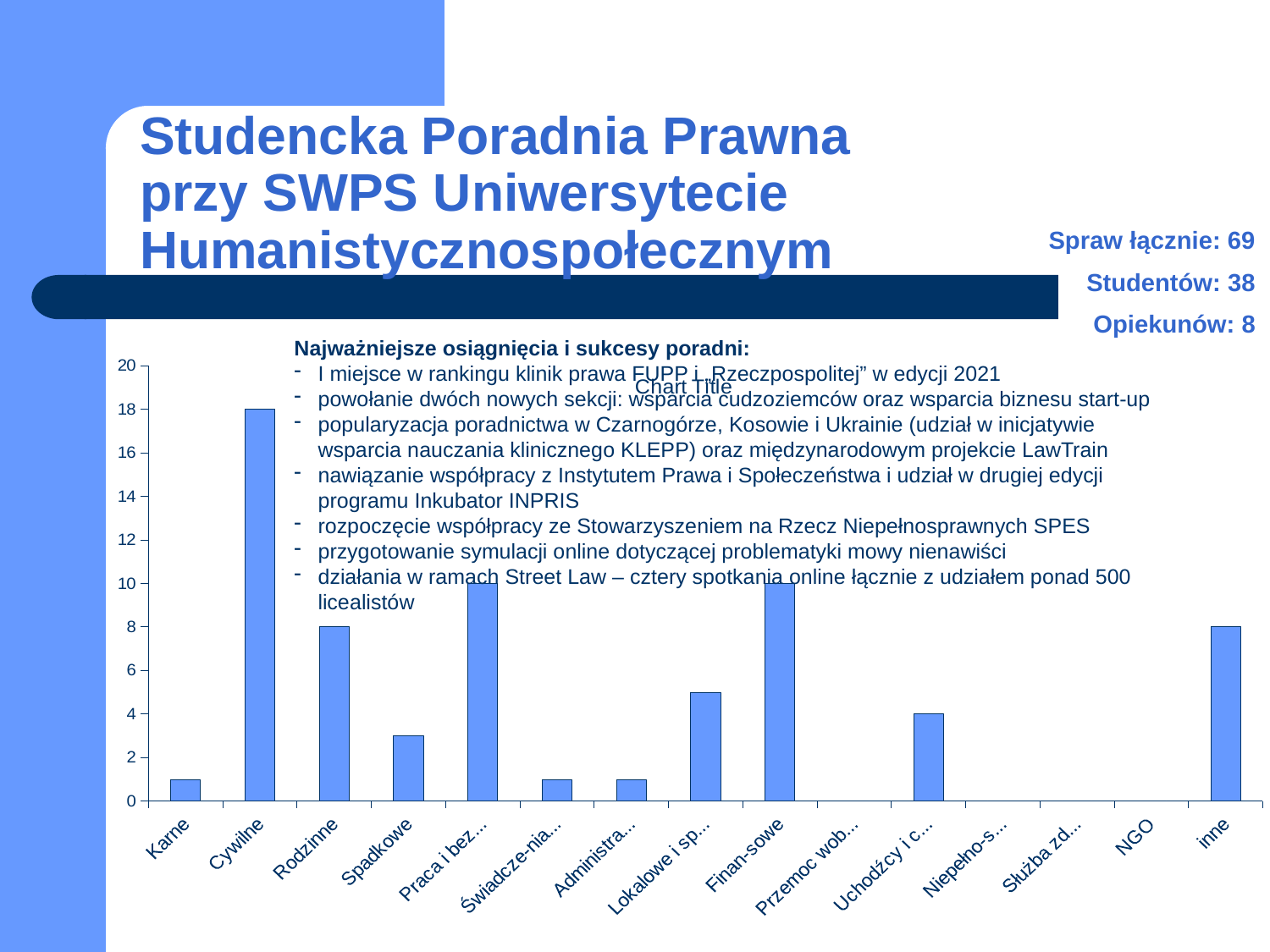
How many categories are shown on the x axis of the chart? 15 Which category has the highest bar in the chart? Cywilne Which is larger, the value for Cywilne or the value for Praca i bez...? Cywilne What is the difference between the values for Cywilne and Rodzinne? 10 What is the value for Uchodźcy i c...? 4 What is the value for inne? 8 What is the value for Cywilne? 18 What type of chart is shown on the slide? bar chart Is the value for Lokalowe i sp... greater or less than 4? greater What is the value for Rodzinne? 8 Is the value for Karne greater or less than 2? less What is the value for Finan-sowe? 10